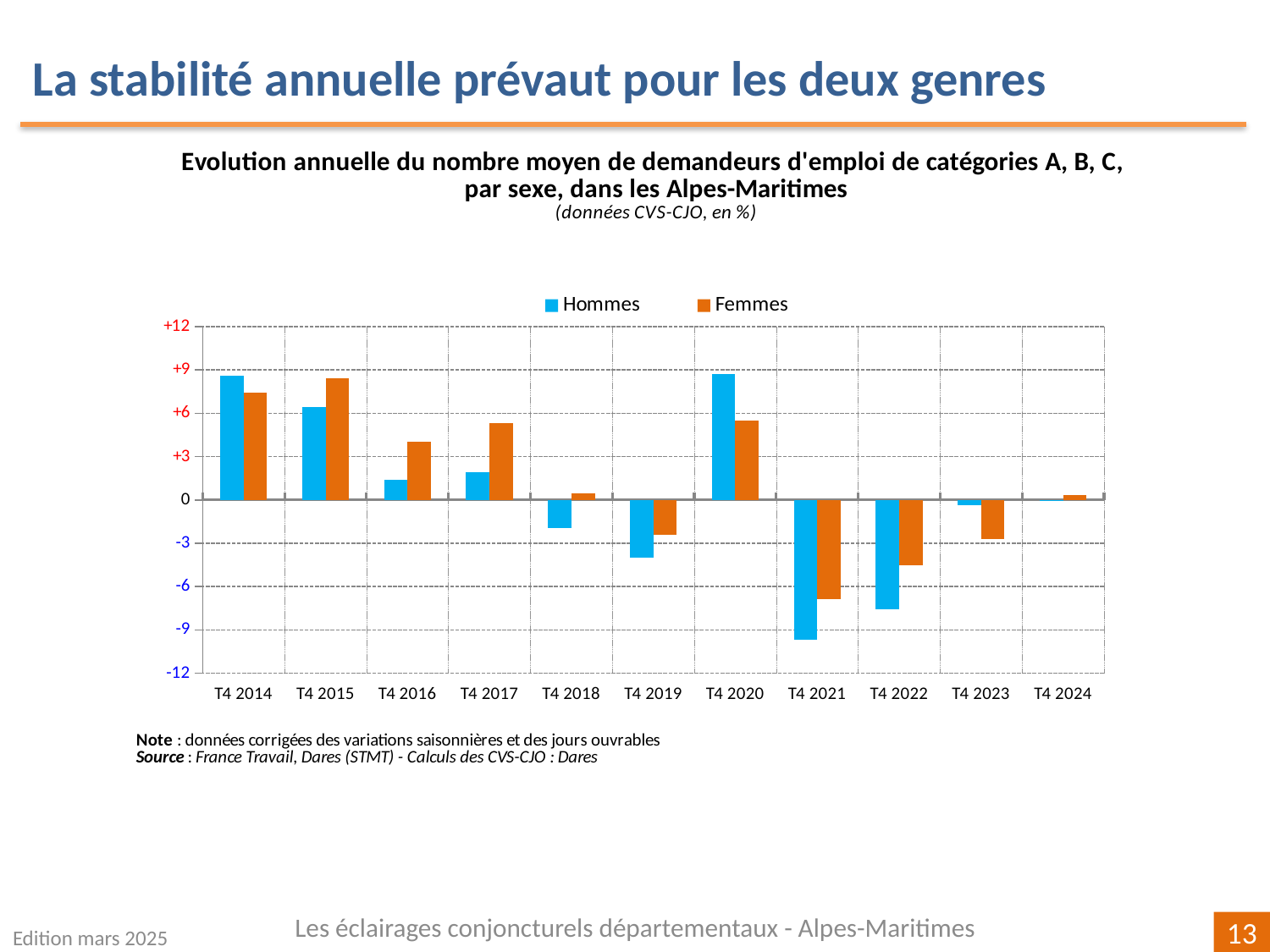
In which quarter is the value for Hommes the lowest? T4 2021 What kind of chart is shown on the slide? bar chart How many series does the legend list? 2 Is the value for Hommes in T4 2021 greater or less than -9? less How many quarters (categories) are shown on the x axis? 11 In T4 2020, which is larger: the value for Hommes or for Femmes? Hommes In T4 2015, which is larger: the value for Hommes or for Femmes? Femmes Is the value for Femmes in T4 2017 greater or less than +3? greater Is the value for Femmes in T4 2021 greater or less than -6? less In which quarter is the value for Femmes the highest? T4 2015 Which series is shown in orange? Femmes In which quarter is the value for Femmes the lowest? T4 2021